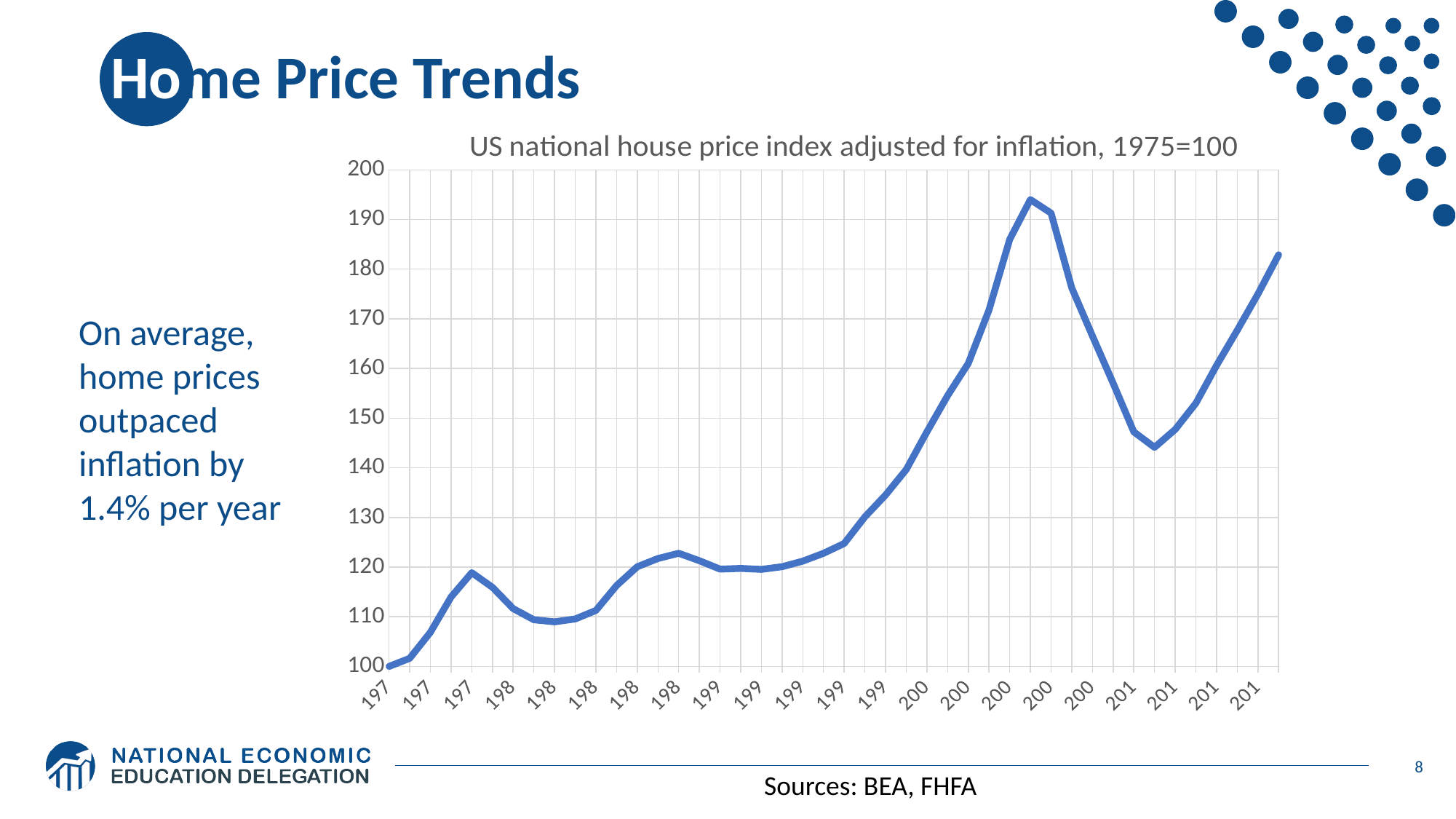
Is the value at the right-hand end of the line greater or less than 180? greater What kind of chart is shown on the slide? line chart Is the lowest value of the line after its highest peak greater or less than 150? less What is the title of the chart? US national house price index adjusted for inflation, 1975=100 What is the index value at the start of the series (1975)? 100 Is the highest value reached by the line greater or less than 190? greater Is the value at the right-hand end of the line higher or lower than the value at the start of the line? higher What is the lowest value shown on the y axis? 100 Is the highest peak of the line higher or lower than the first local peak in the left part of the chart? higher Overall, does the index rise or fall from the left of the chart to the right? rise